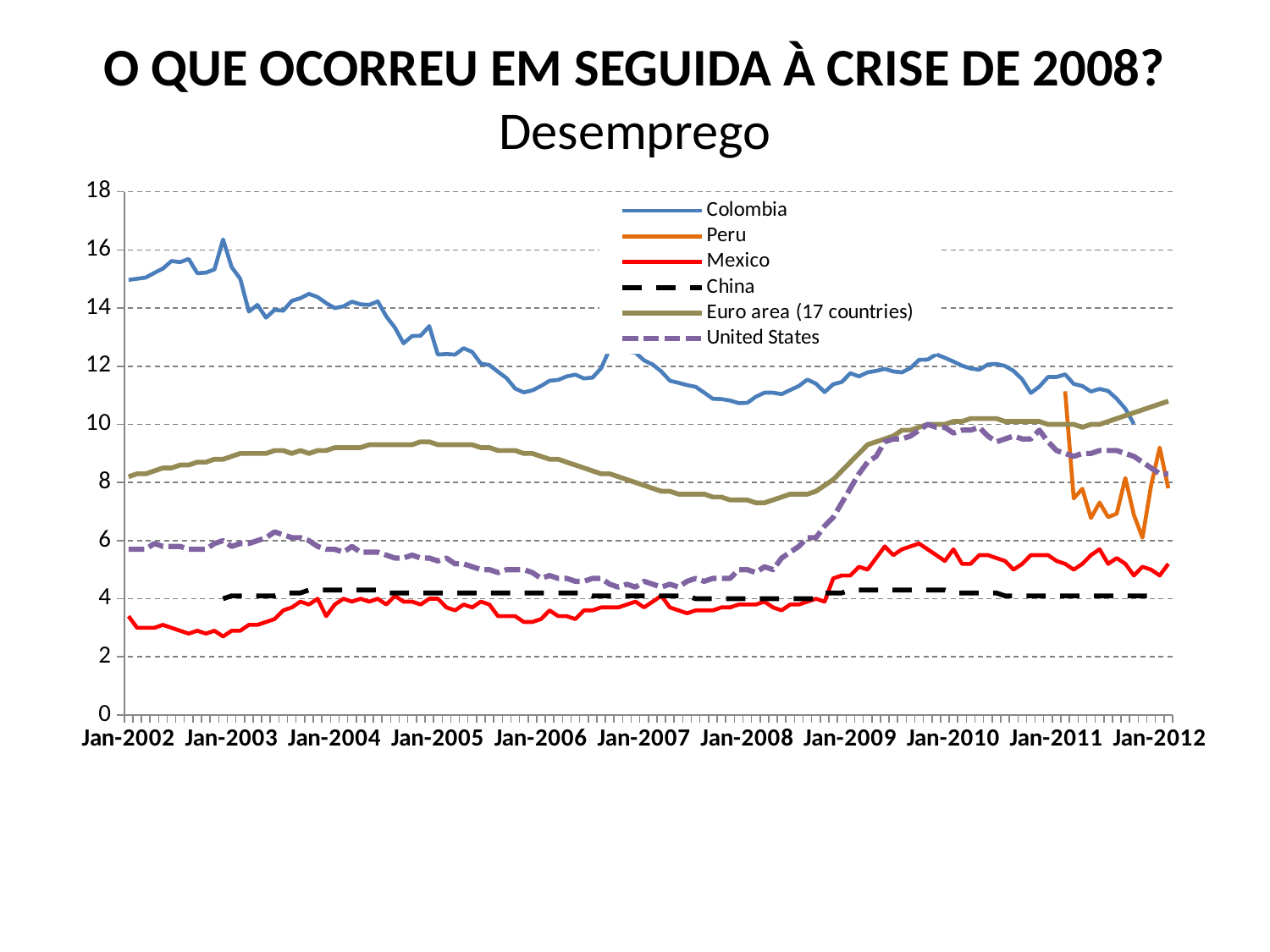
Is the value for United States at Jan-2010 greater or less than 8? greater How many series does the legend list? 6 Which series has the highest value at Jan-2002? Colombia At Jan-2010, which is higher, Euro area (17 countries) or Mexico? Euro area (17 countries) Does the Colombia line generally rise or fall from Jan-2002 to Jan-2012? fall Which series has the lowest value at Jan-2002? Mexico Which series is drawn with a black dashed line? China Does the United States line rise or fall from Jan-2008 to Jan-2010? rise Is the value for Colombia at Jan-2002 greater or less than 14? greater Is the value for China at Jan-2011 greater or less than 6? less What kind of chart is shown on the slide? line chart